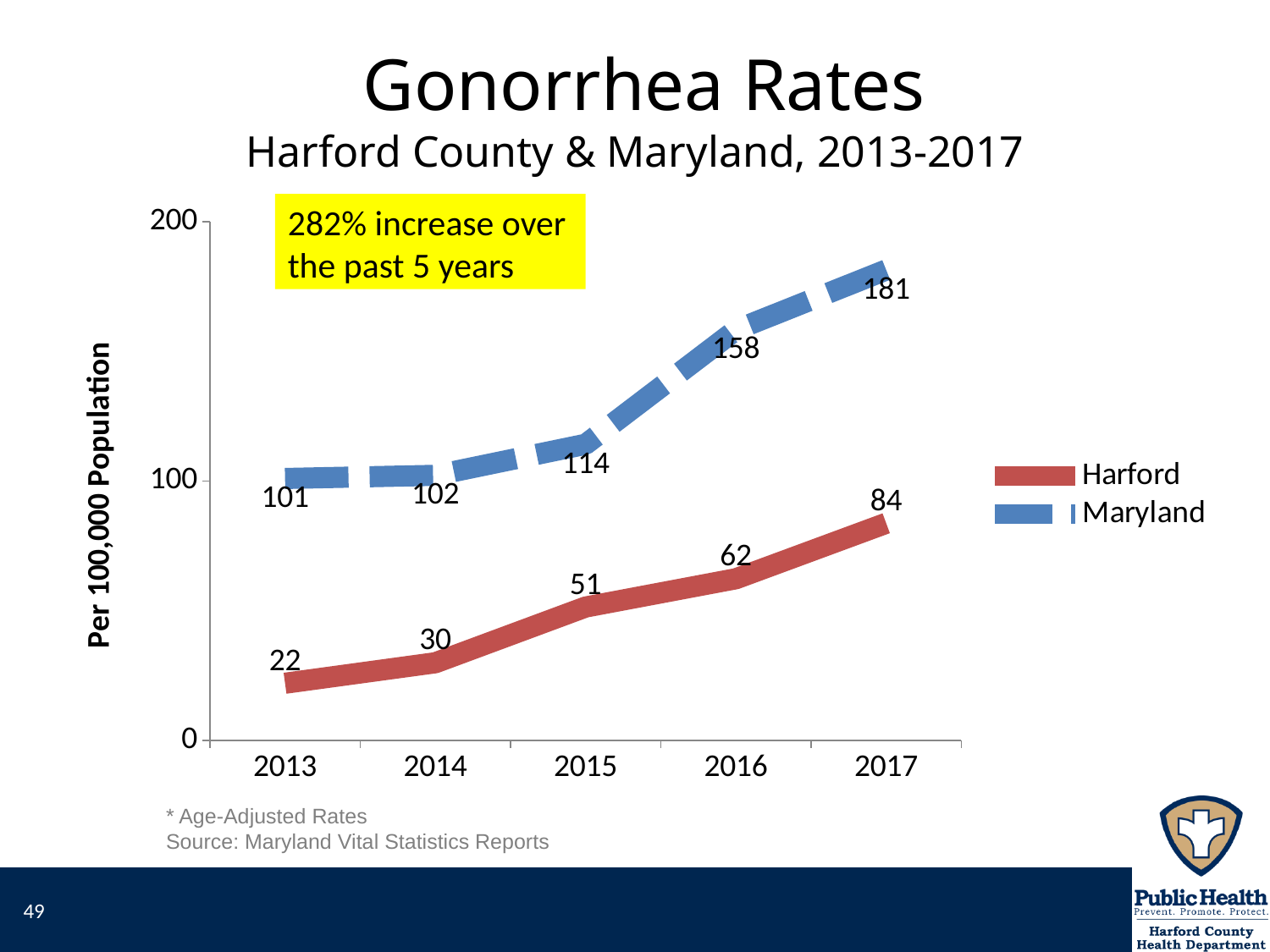
Which had the higher gonorrhea rate in 2016, Harford or Maryland? Maryland What was the gonorrhea rate for Maryland in 2017? 181 What kind of chart is shown on the slide? Line chart By how much did the Harford gonorrhea rate increase from 2013 to 2017? 62 Is the Maryland gonorrhea rate in 2015 greater or less than 100? greater In which year was the Harford gonorrhea rate lowest? 2013 What was the gonorrhea rate for Harford in 2015? 51 What is the difference between the Maryland and Harford gonorrhea rates in 2017? 97 In which year was the Maryland gonorrhea rate highest? 2017 How many series does the legend list? 2 What was the gonorrhea rate for Harford in 2013? 22 How many years are shown on the x axis? 5